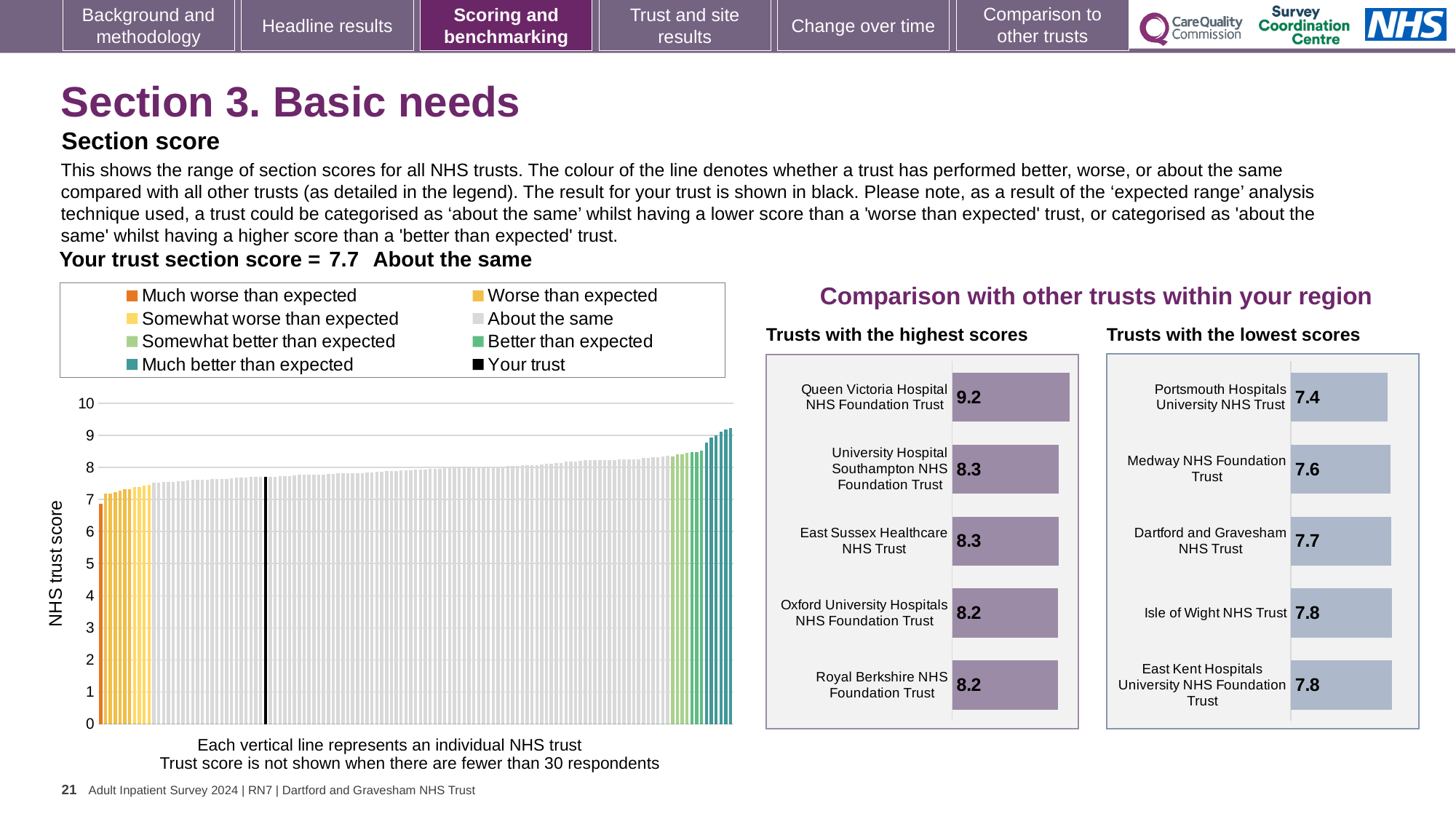
In the 'Trusts with the lowest scores' chart, what is the difference between the scores of Dartford and Gravesham NHS Trust and Portsmouth Hospitals University NHS Trust? 0.3 How many entries does the legend of the large chart on the left list? 8 In the 'Trusts with the highest scores' chart, which trust has the highest score? Queen Victoria Hospital NHS Foundation Trust In the 'Trusts with the lowest scores' chart, which has the larger score: Medway NHS Foundation Trust or Isle of Wight NHS Trust? Isle of Wight NHS Trust How many trusts are shown in the 'Trusts with the highest scores' chart? 5 In the large chart on the left showing all NHS trusts, is the value of the tallest bar greater or less than 9? greater In the large chart on the left showing all NHS trusts, what is the section score for your trust (the black bar)? 7.7 In the 'Trusts with the lowest scores' chart, what is the score for Medway NHS Foundation Trust? 7.6 In the large chart on the left showing all NHS trusts, do the bar values rise or fall from left to right? rise In the 'Trusts with the lowest scores' chart, which trust has the lowest score? Portsmouth Hospitals University NHS Trust In the 'Trusts with the highest scores' chart, what is the score for Queen Victoria Hospital NHS Foundation Trust? 9.2 In the 'Trusts with the highest scores' chart, what is the difference between the scores of Queen Victoria Hospital NHS Foundation Trust and Oxford University Hospitals NHS Foundation Trust? 1.0